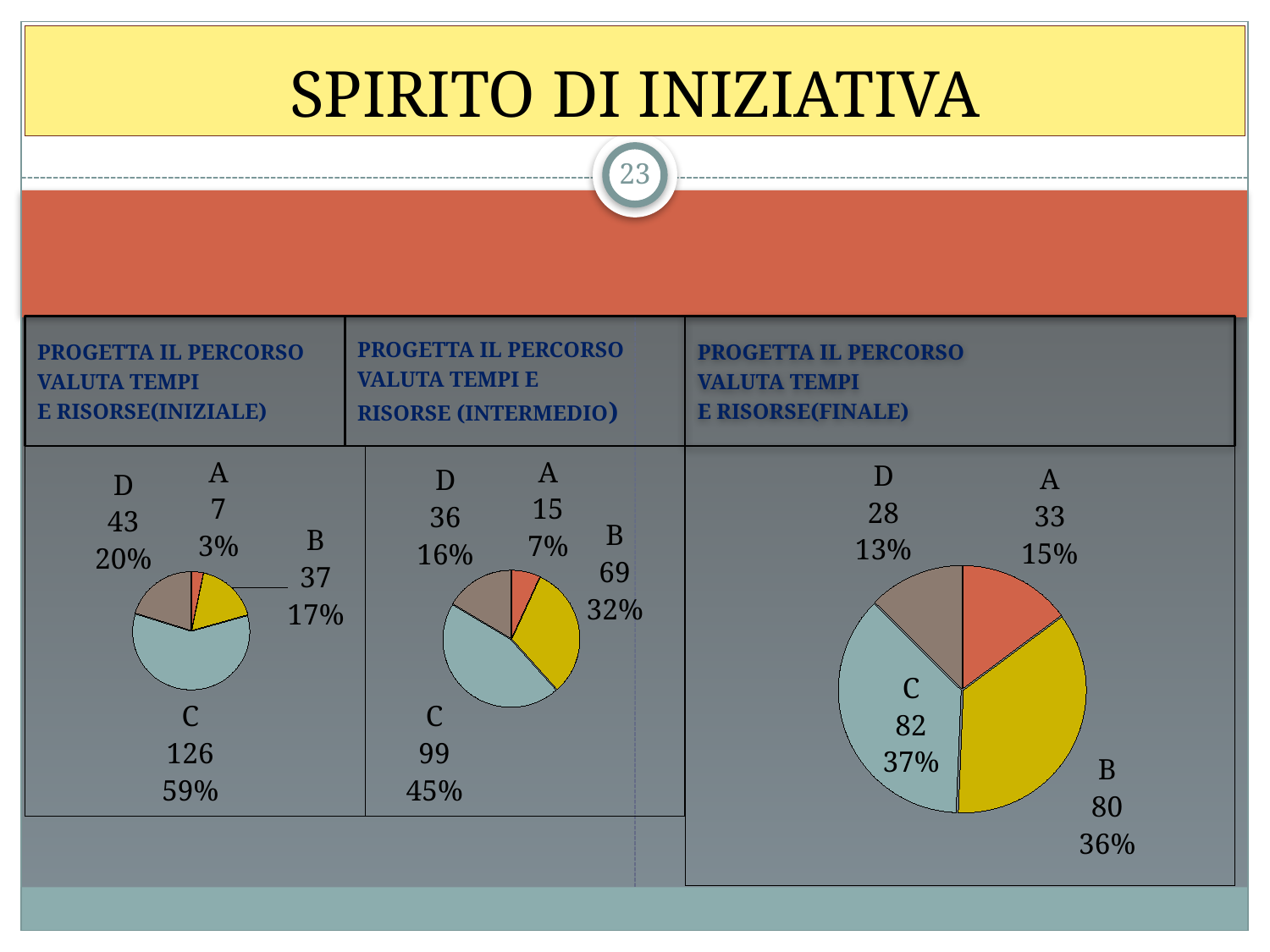
In the INTERMEDIO pie chart (middle), what is the difference between the values for C and D? 63 In the INIZIALE pie chart (left), which is larger, the value for D or the value for B? D In the INTERMEDIO pie chart (middle), which category has the largest slice? C What type of chart is used in the INIZIALE panel (left)? Pie chart In the INIZIALE pie chart (left), what percentage share does category A have? 3% In the FINALE pie chart (right), what is the difference between the values for C and B? 2 In the FINALE pie chart (right), what is the value for category D? 28 In the INTERMEDIO pie chart (middle), what is the value for category B? 69 In the INIZIALE pie chart (left), what is the value for category C? 126 In the INTERMEDIO pie chart (middle), which category has the smallest slice? A How many categories does the FINALE pie chart (right) show? 4 In the FINALE pie chart (right), what percentage share does category B have? 36%